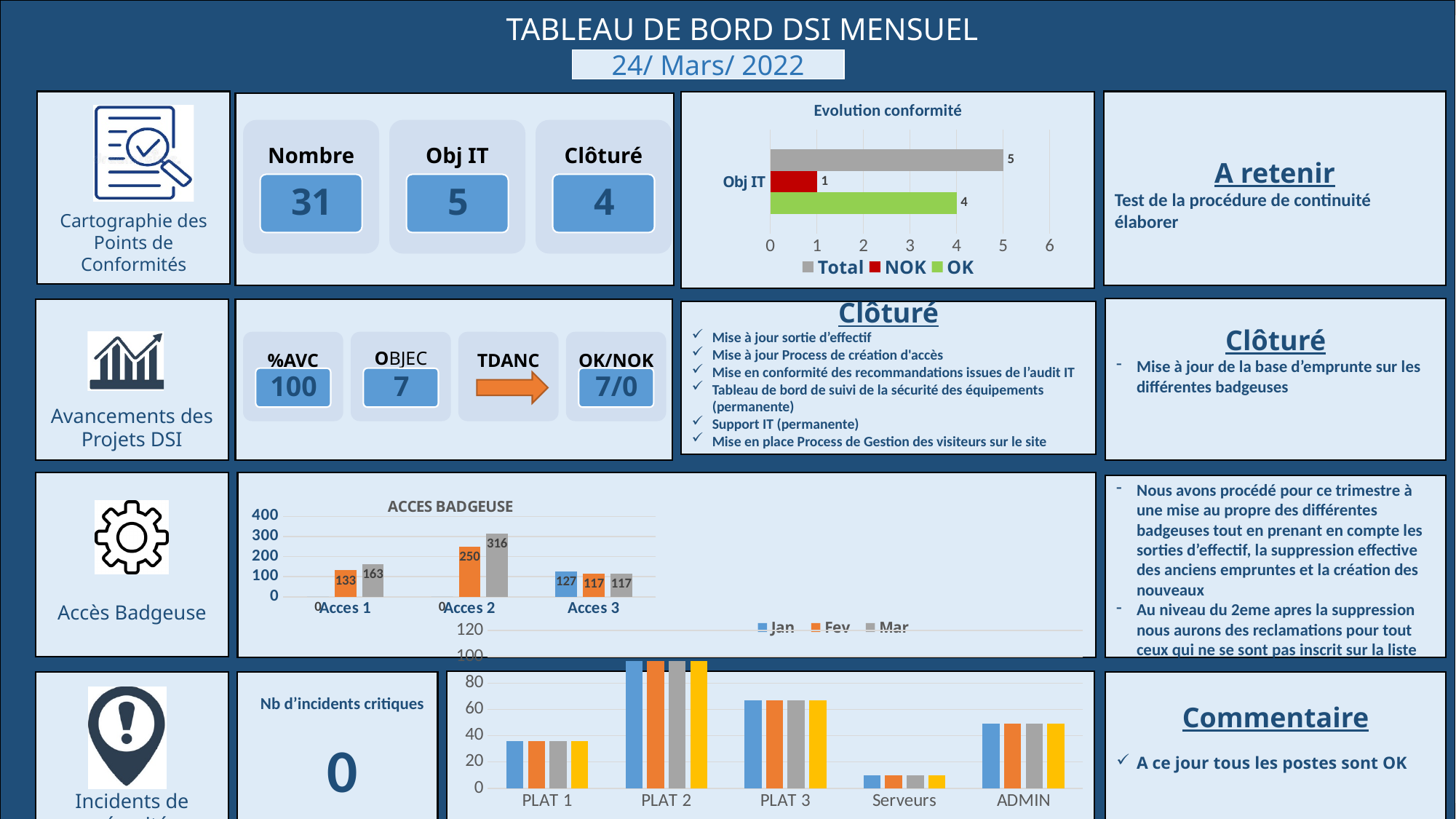
In the 'Evolution conformité' chart, how many series does the legend list? 3 In the 'Evolution conformité' chart, what is the value of the NOK series? 1 In the 'ACCES BADGEUSE' chart, what is the Fev value for Acces 1? 133 In the bottom chart with categories PLAT 1 to ADMIN, which category has the highest bars? PLAT 2 In the 'Evolution conformité' chart, what is the difference between the OK value and the NOK value? 3 In the 'ACCES BADGEUSE' chart, which is larger for Acces 3: the Jan value or the Fev value? Jan In the 'ACCES BADGEUSE' chart, which category has the highest Mar value? Acces 2 In the 'Evolution conformité' chart, what is the value of the Total series for Obj IT? 5 In the 'ACCES BADGEUSE' chart, what is the difference between the Mar and Fev values for Acces 2? 66 In the bottom chart with categories PLAT 1 to ADMIN, is the value for Serveurs greater or less than 20? less In the 'ACCES BADGEUSE' chart, how many categories are shown on the x axis? 3 In the 'ACCES BADGEUSE' chart, what is the Mar value for Acces 2? 316